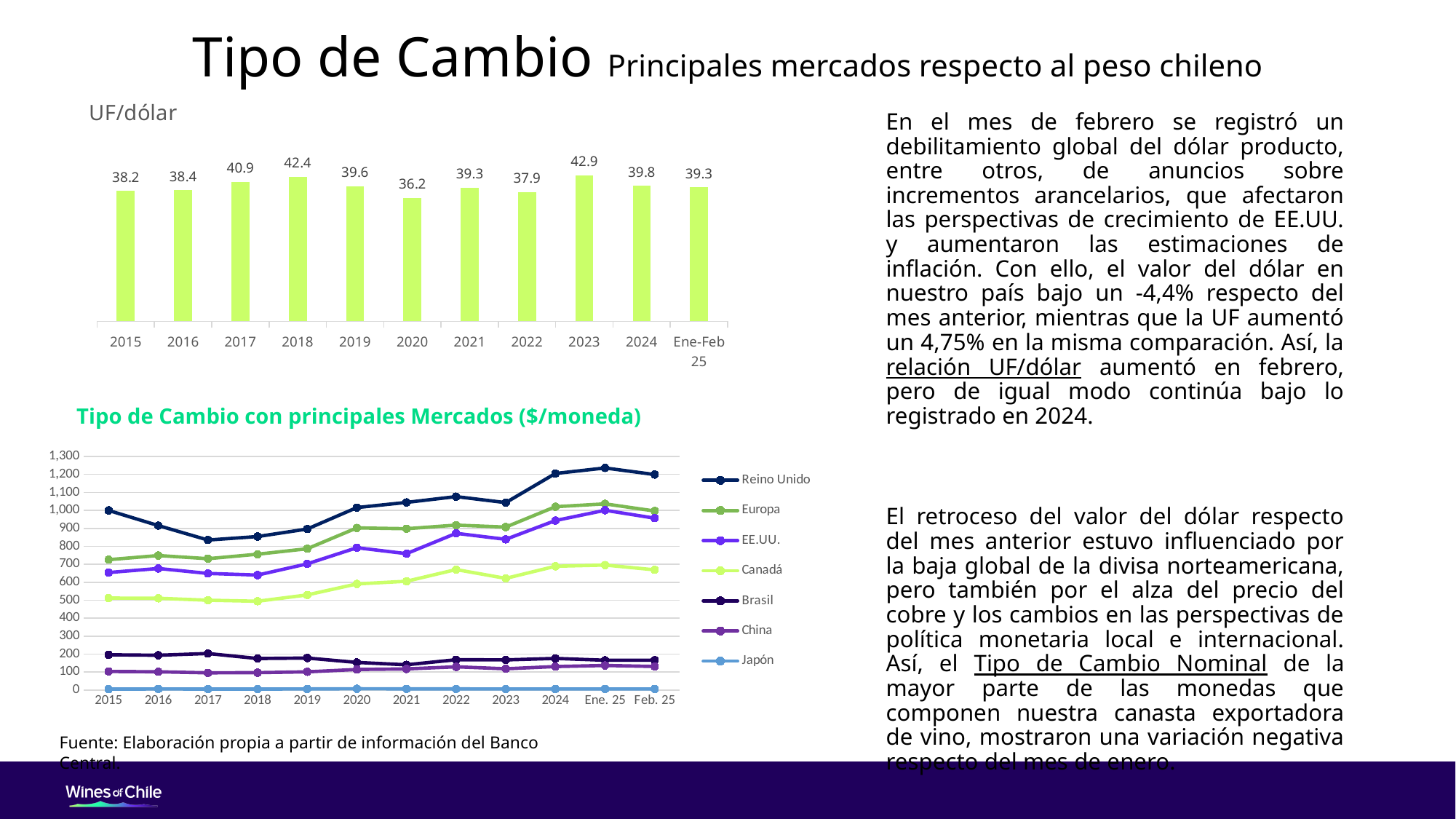
What kind of chart is the UF/dólar chart? Bar chart In the UF/dólar chart, which year has the lowest value? 2020 How many series does the legend of the 'Tipo de Cambio con principales Mercados ($/moneda)' chart list? 7 How many bars are shown in the UF/dólar chart? 11 In the UF/dólar chart, which year has the highest value? 2023 In the 'Tipo de Cambio con principales Mercados ($/moneda)' chart, is the value for Reino Unido in 2024 greater or less than 1,100? greater In the UF/dólar chart, what is the difference between the 2023 value and the 2020 value? 6.7 In the UF/dólar chart, which is larger, the value for 2017 or the value for 2022? 2017 What kind of chart is the 'Tipo de Cambio con principales Mercados ($/moneda)' chart? Line chart In the 'Tipo de Cambio con principales Mercados ($/moneda)' chart, which series has the lowest values across all years? Japón In the UF/dólar chart, what is the value for 2018? 42.4 In the UF/dólar chart, what is the value for Ene-Feb 25? 39.3